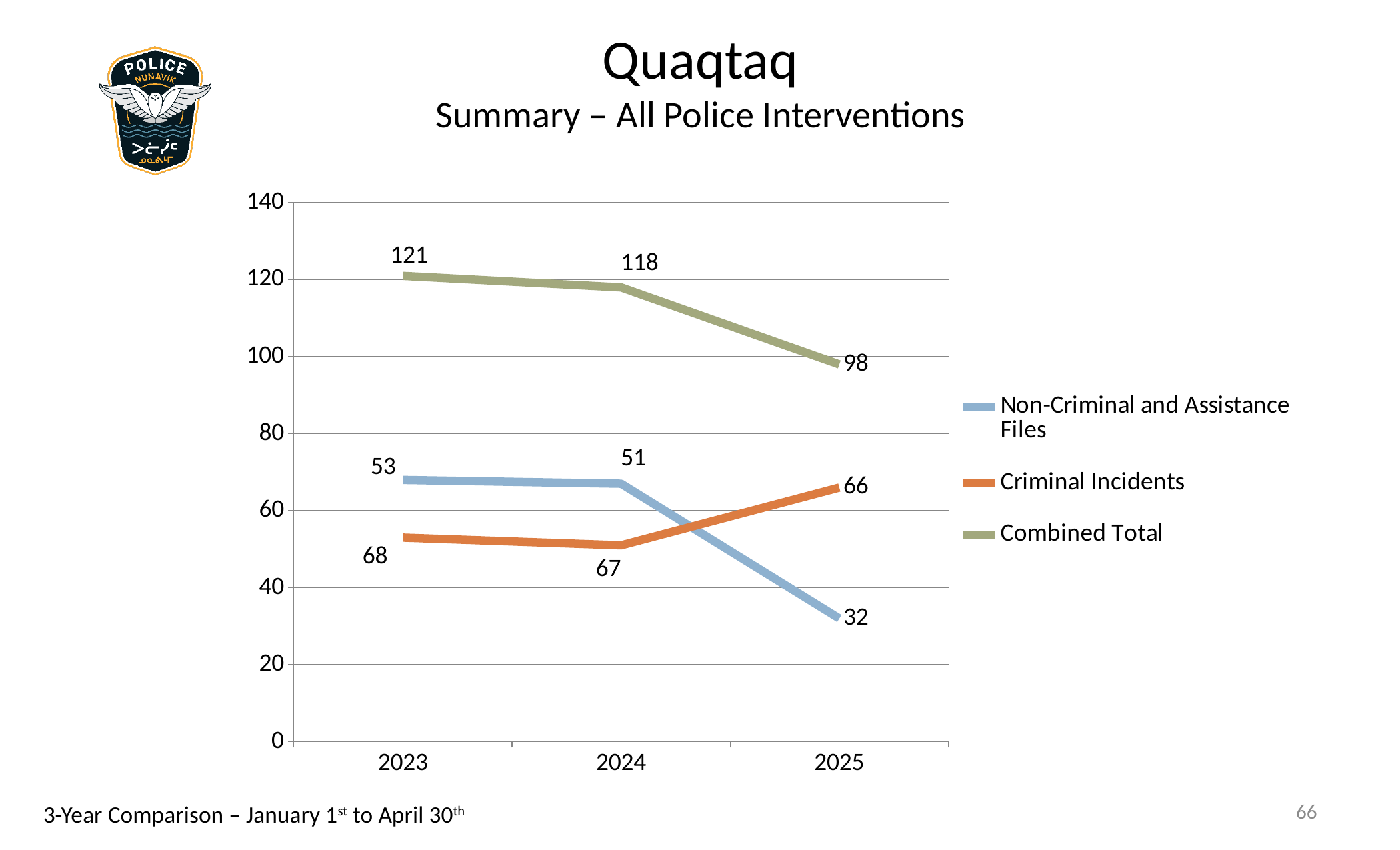
What is the Combined Total value for 2024? 118 What kind of chart is shown on the slide? Line chart What is the value for Non-Criminal and Assistance Files in 2025? 32 In which year is the Combined Total highest? 2023 In 2025, which is larger: Criminal Incidents or Non-Criminal and Assistance Files? Criminal Incidents What is the value for Criminal Incidents in 2025? 66 What is the Combined Total value for 2025? 98 Does the Combined Total rise or fall from 2023 to 2025? Fall In which year is the Combined Total lowest? 2025 How many series does the legend list? 3 By how much did the Combined Total decrease from 2023 to 2025? 23 What is the Combined Total value for 2023? 121